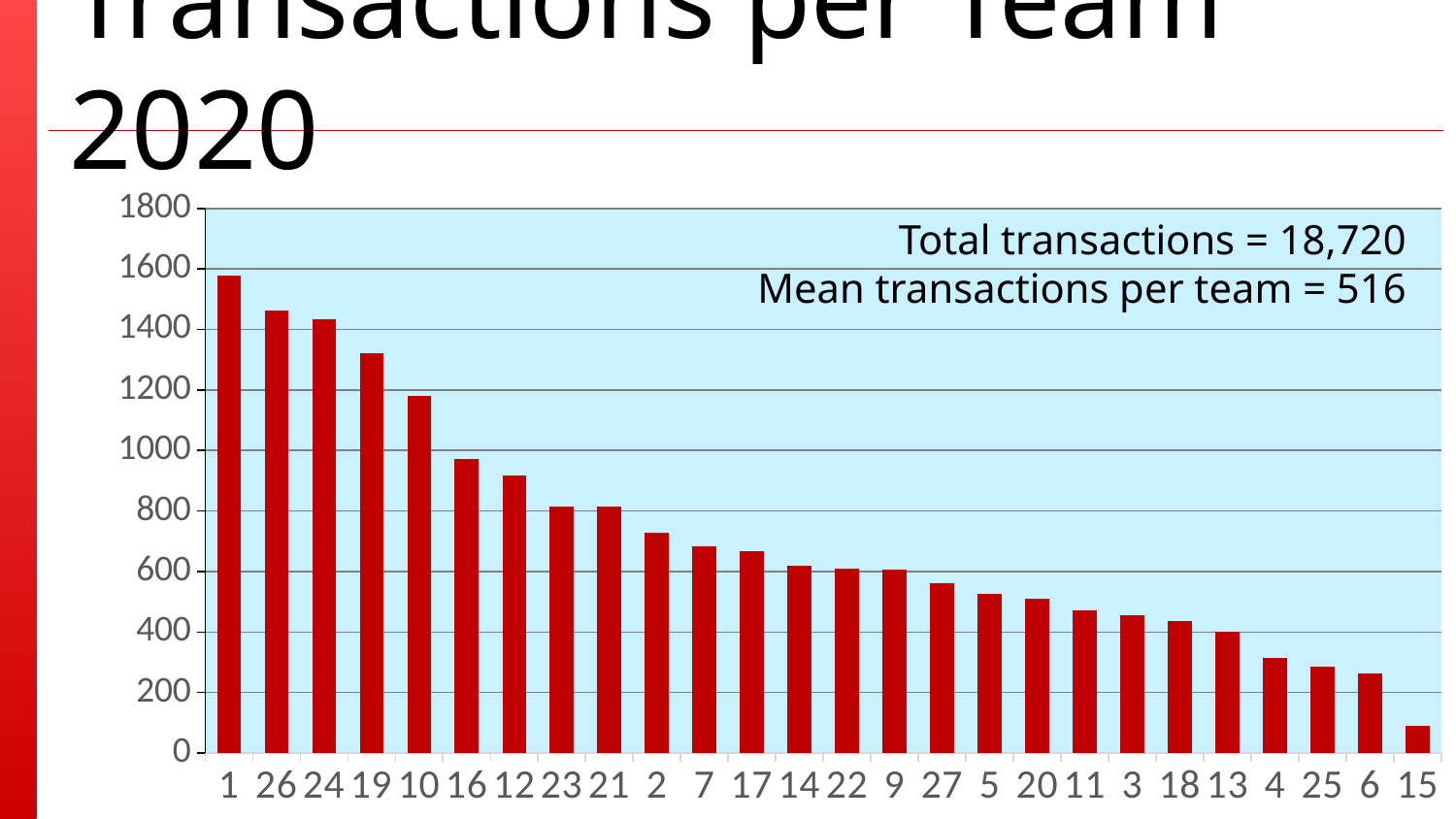
According to the text on the chart, what is the mean number of transactions per team? 516 Which team has the highest number of transactions? 1 Is the value for team 15 greater or less than 200? less Is the value for team 1 greater or less than 1400? greater Which team has more transactions, team 19 or team 2? 19 Is the value for team 3 greater or less than 600? less How many teams are shown on the x axis of the chart? 26 What kind of chart is shown on the slide? bar chart Do the bar values rise or fall from left to right along the x axis? fall Which team has the lowest number of transactions? 15 According to the text on the chart, what is the total number of transactions? 18,720